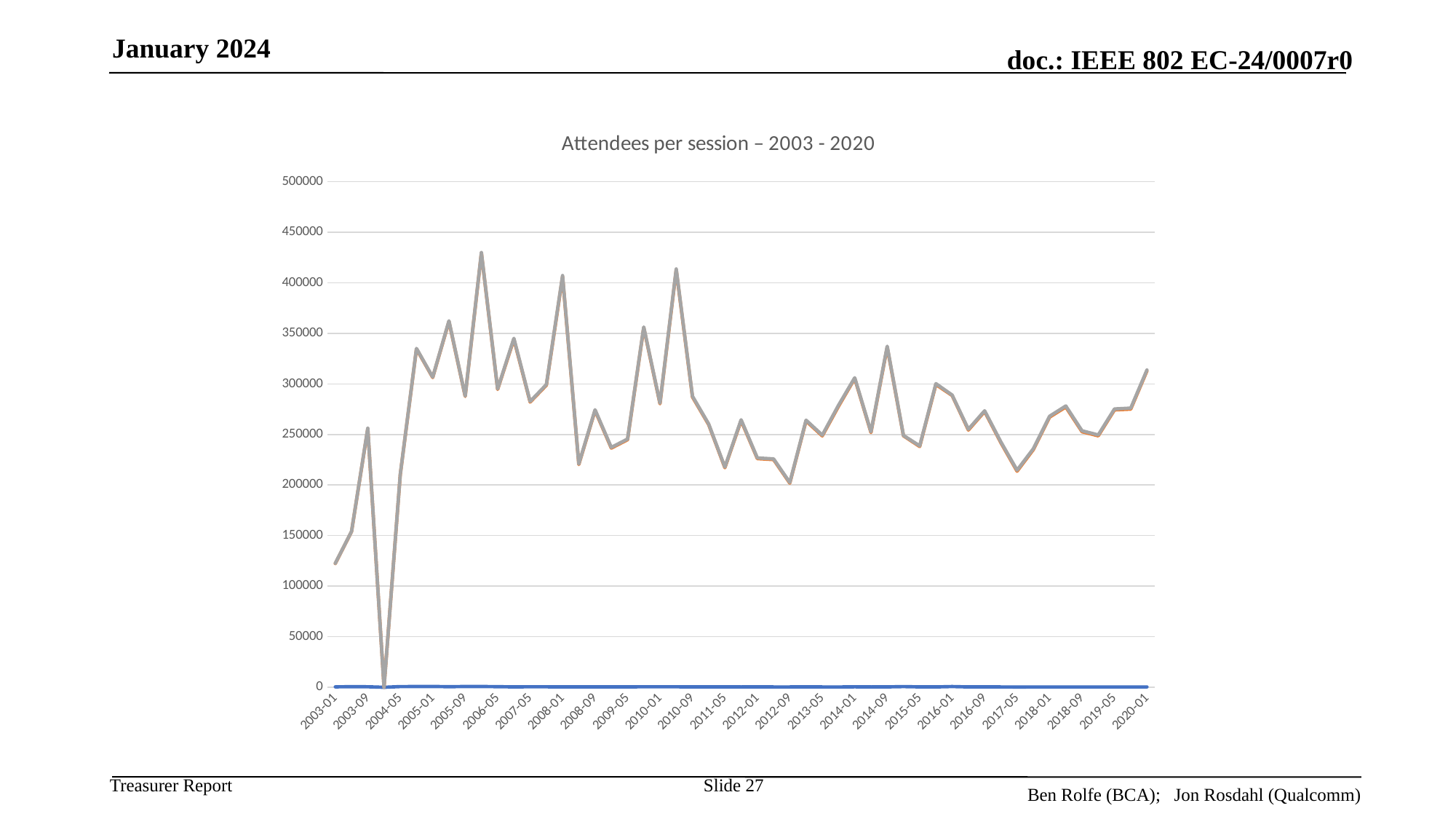
Is the value for 2008-01 greater or less than 350000? greater Does the value rise or fall from 2003-01 to 2003-09? rise Is the value for 2020-01 greater or less than 300000? greater Which has the larger value, 2003-01 or 2020-01? 2020-01 What kind of chart is shown on the slide? line chart Is the value for 2004-05 greater or less than 50000? greater What is the title of the chart? Attendees per session – 2003 - 2020